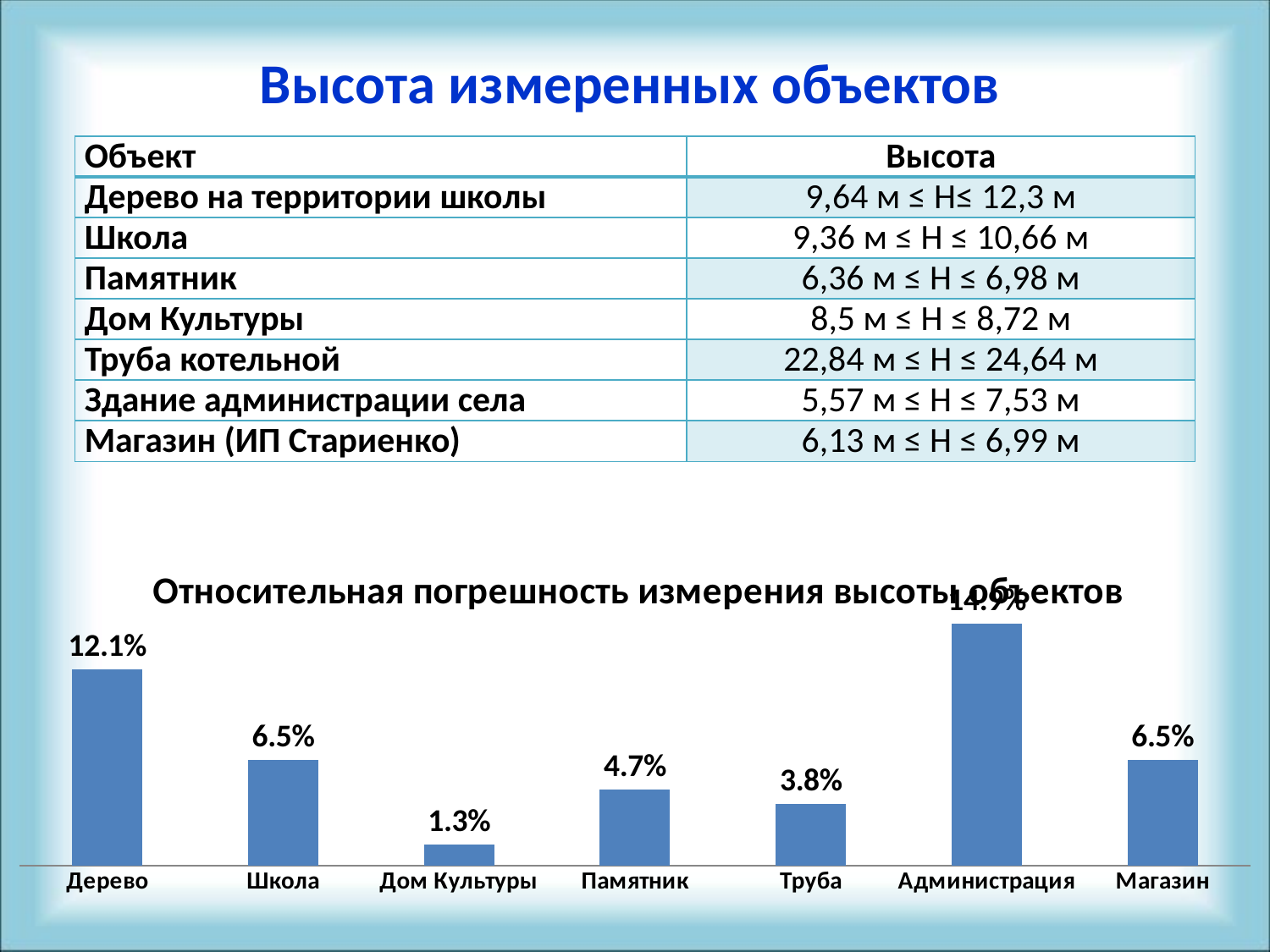
What is the relative error value for Дом Культуры? 1.3% What is the relative error value for Дерево? 12.1% What is the relative error value for Памятник? 4.7% What type of chart is used to show the relative error of height measurements? Bar chart Which object has the highest relative error in the chart? Администрация Which has a larger relative error, Памятник or Труба? Памятник What is the relative error value for Магазин? 6.5% Which object has the lowest relative error in the chart? Дом Культуры What is the relative error value for Труба? 3.8% What is the relative error value for Школа? 6.5% What is the difference between the relative error for Дерево and for Школа? 5.6% How many objects are shown in the bar chart? 7